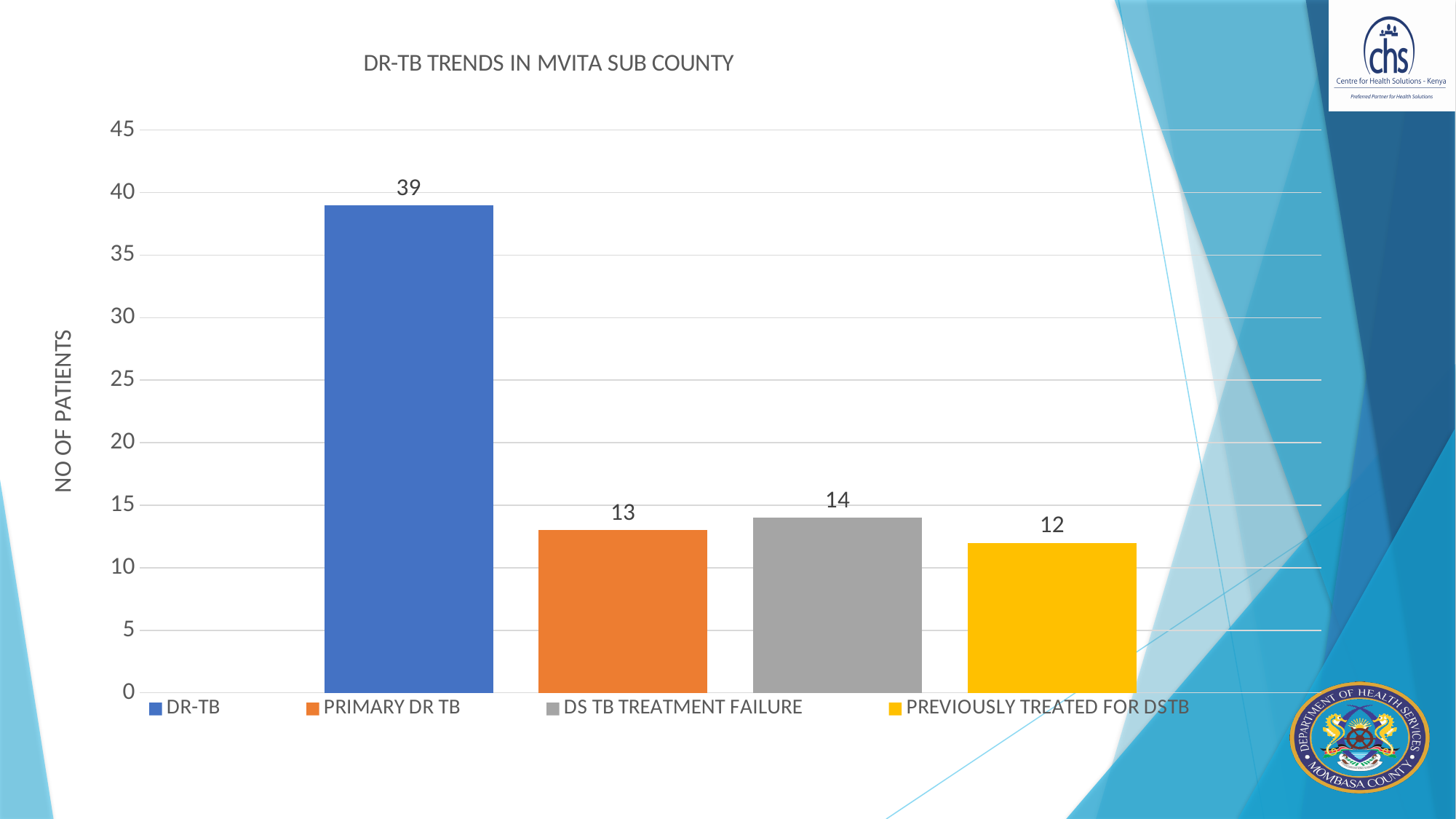
Which category has the highest value? DR-TB What is the difference between the values for DR-TB and PRIMARY DR TB? 26 What is the value for PRIMARY DR TB? 13 What is the value for PREVIOUSLY TREATED FOR DSTB? 12 What is the value for DS TB TREATMENT FAILURE? 14 What is the difference between the values for DS TB TREATMENT FAILURE and PREVIOUSLY TREATED FOR DSTB? 2 Which category has the lowest value? PREVIOUSLY TREATED FOR DSTB What is the value for DR-TB? 39 What is the title of the chart? DR-TB TRENDS IN MVITA SUB COUNTY What kind of chart is shown on the slide? Bar chart How many bars are shown in the chart? 4 Which is larger, the value for DS TB TREATMENT FAILURE or the value for PRIMARY DR TB? DS TB TREATMENT FAILURE